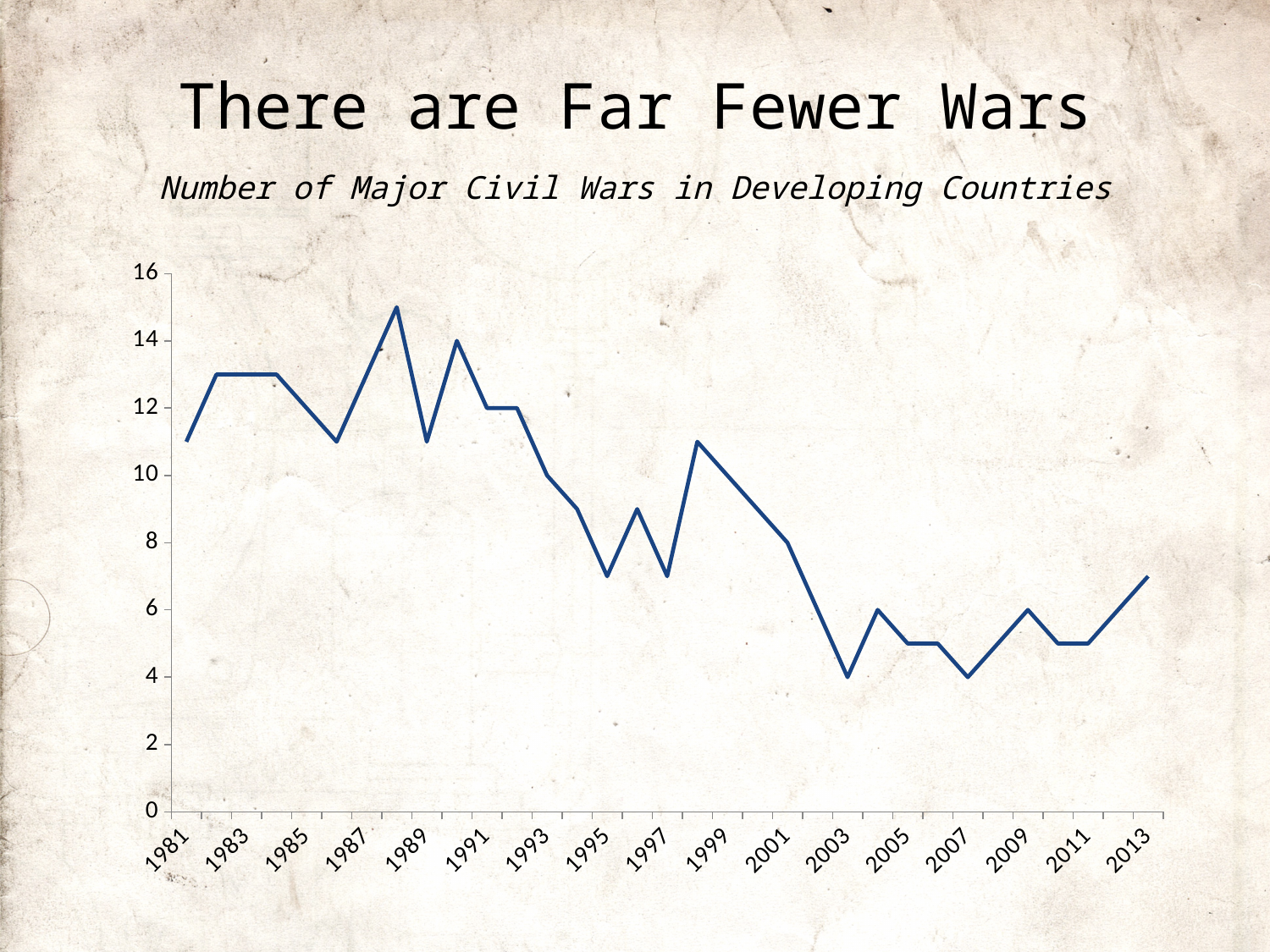
Is the value for 2013 greater or less than 8? less Overall, do the values rise or fall from 1981 to 2013? fall What is the number of major civil wars in 1991? 12 What is the number of major civil wars in 1993? 10 What type of chart is shown on the slide? line chart What is the number of major civil wars in 2003? 4 What is the number of major civil wars in 2001? 8 What is the subtitle describing the chart's data? Number of Major Civil Wars in Developing Countries Which year has more major civil wars, 1983 or 2013? 1983 What is the number of major civil wars in 2009? 6 Is the value for 1983 greater or less than 12? greater What is the difference between the number of major civil wars in 1993 and in 2003? 6